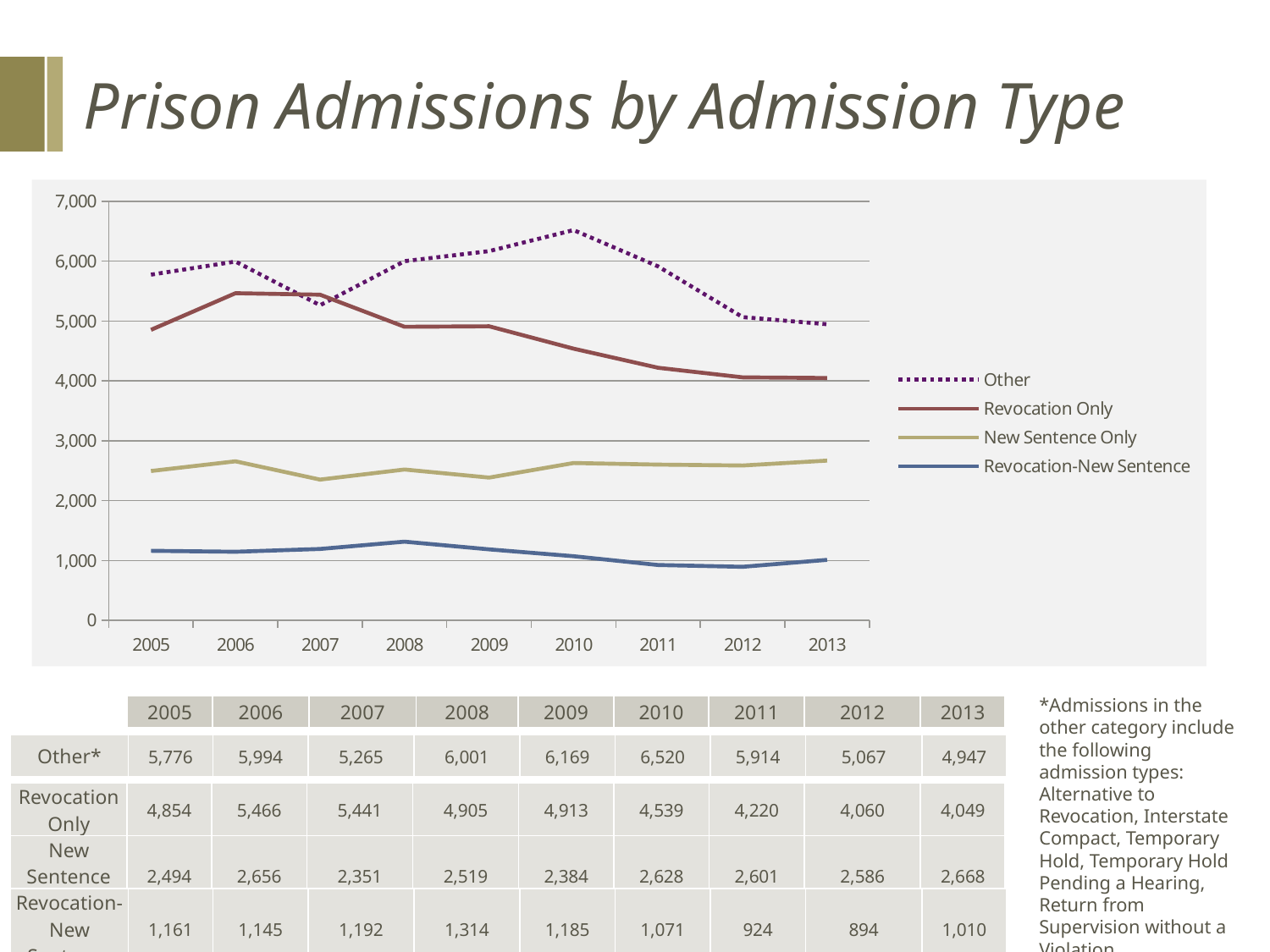
What is the value for New Sentence Only in 2013? 2,668 In which year is the Revocation-New Sentence series at its lowest? 2012 Is the value for Other in 2009 greater or less than 6,000? greater What is the title of the slide? Prison Admissions by Admission Type In which year does the Other series reach its highest value? 2010 In 2007, which is larger: Other or Revocation Only? Revocation Only What is the value for Other in 2010? 6,520 What is the difference between the Revocation Only values in 2006 and 2013? 1,417 How many series does the legend list? 4 What kind of chart is shown on the slide? line chart How many years are plotted along the x axis? 9 Does the Revocation Only series rise or fall from 2008 to 2013? fall